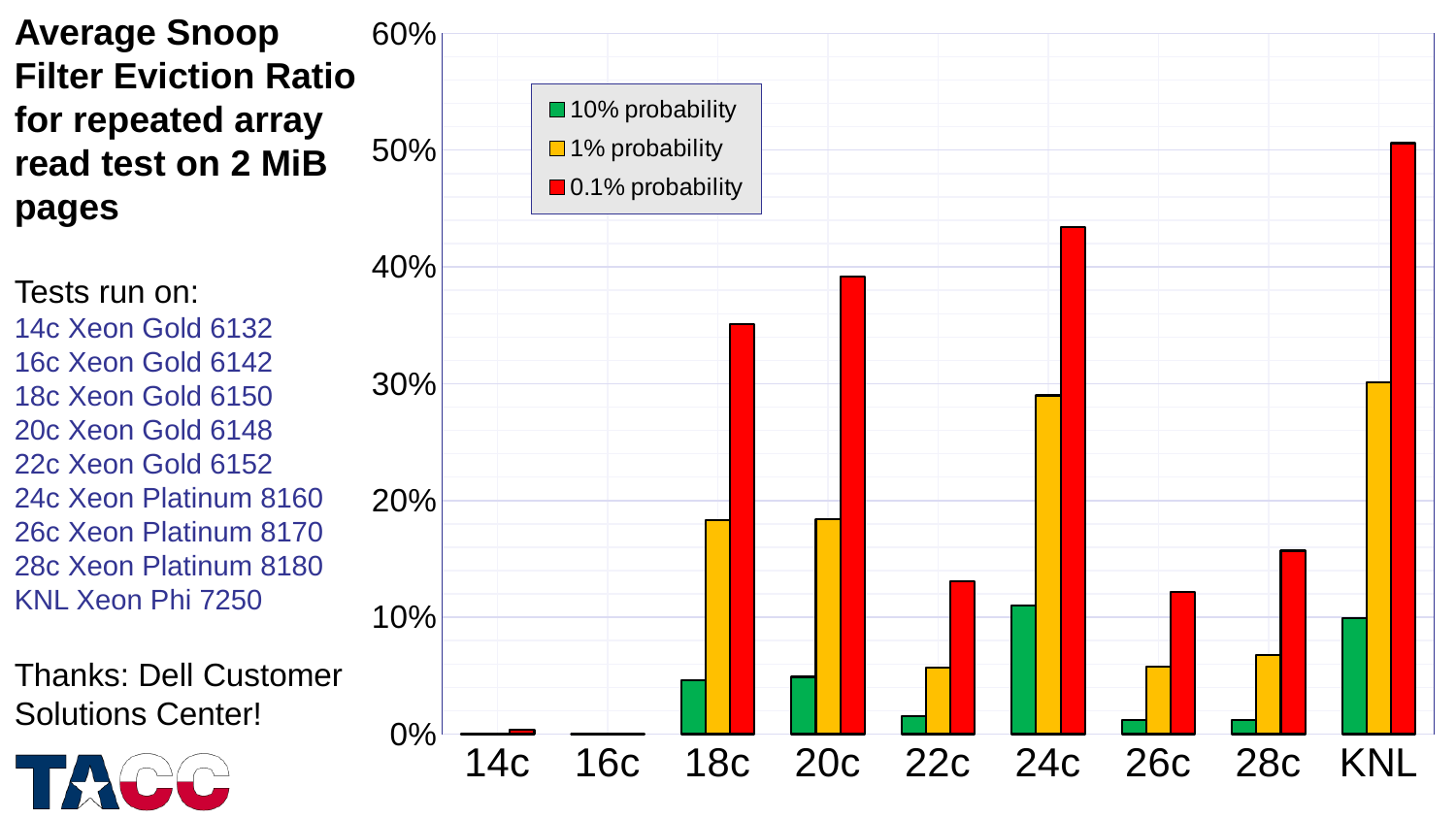
How many processor categories are shown on the x axis? 9 How many series does the legend list? 3 Is the 0.1% probability value for 18c greater or less than 30%? greater Is the 0.1% probability value for 20c greater or less than 40%? less Is the 0.1% probability value for 24c greater or less than 40%? greater Which category has the highest value for the 1% probability series? KNL Which colour represents the 10% probability series in the legend? green What kind of chart is shown on the slide? bar chart Which is larger, the 0.1% probability value for 20c or for 18c? 20c Which category has the highest value for the 0.1% probability series? KNL